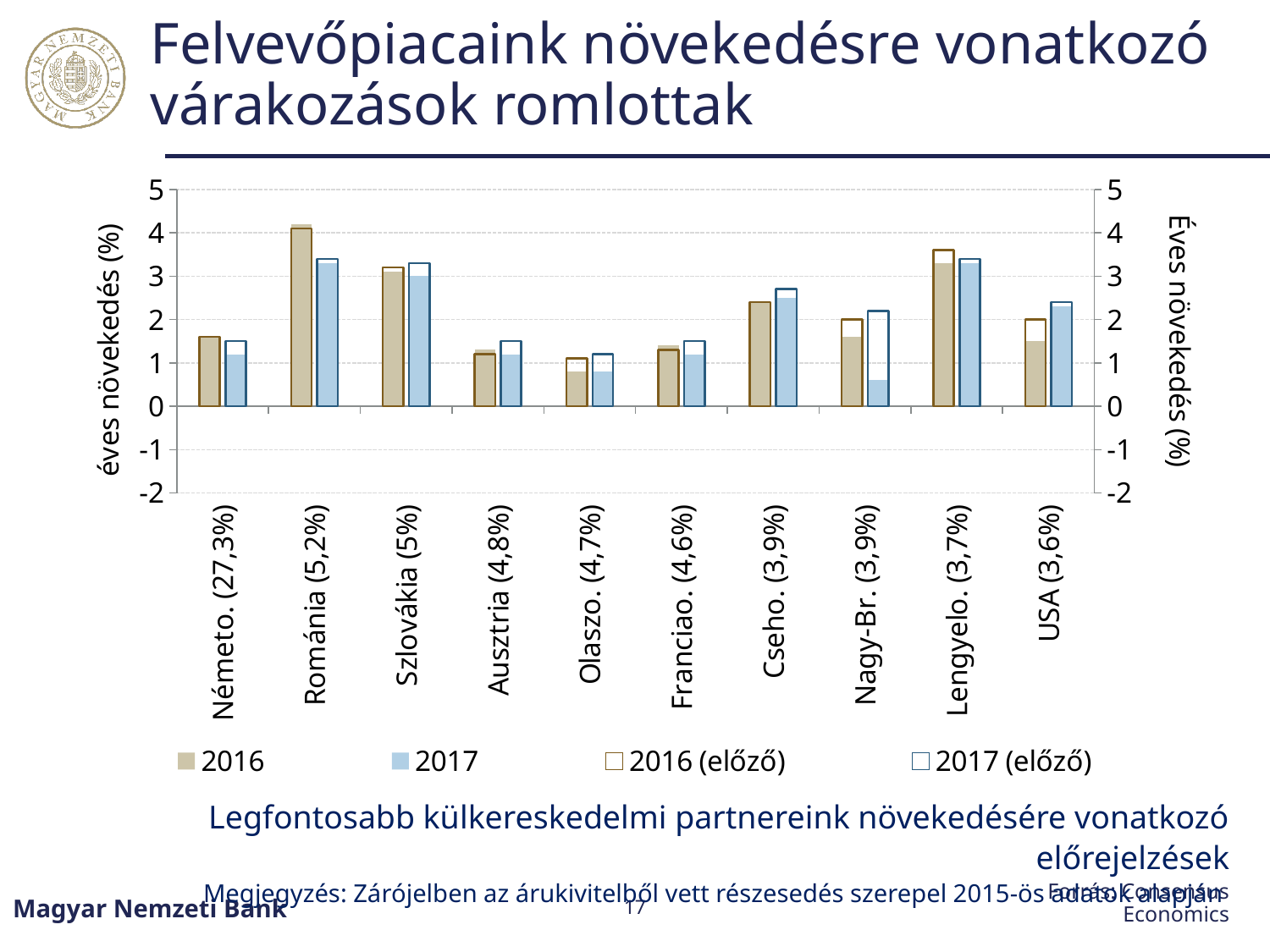
For Nagy-Br. (3,9%), which is larger: the 2016 value or the 2017 value? 2016 Is the 2016 value for Németo. (27,3%) greater or less than 2? less How many series does the chart's legend list? 4 Is the 2017 value for Nagy-Br. (3,9%) greater or less than 1? less Is the 2017 value for USA (3,6%) greater or less than 2? greater How many countries (categories) are shown on the x axis of the chart? 10 Which country has the highest 2016 value in the chart? Románia (5,2%) What kind of chart is shown on the slide? bar chart What is the label of the left vertical axis of the chart? éves növekedés (%) Which country has the lowest 2016 value in the chart? Olaszo. (4,7%) Which country has the lowest 2017 value in the chart? Nagy-Br. (3,9%)